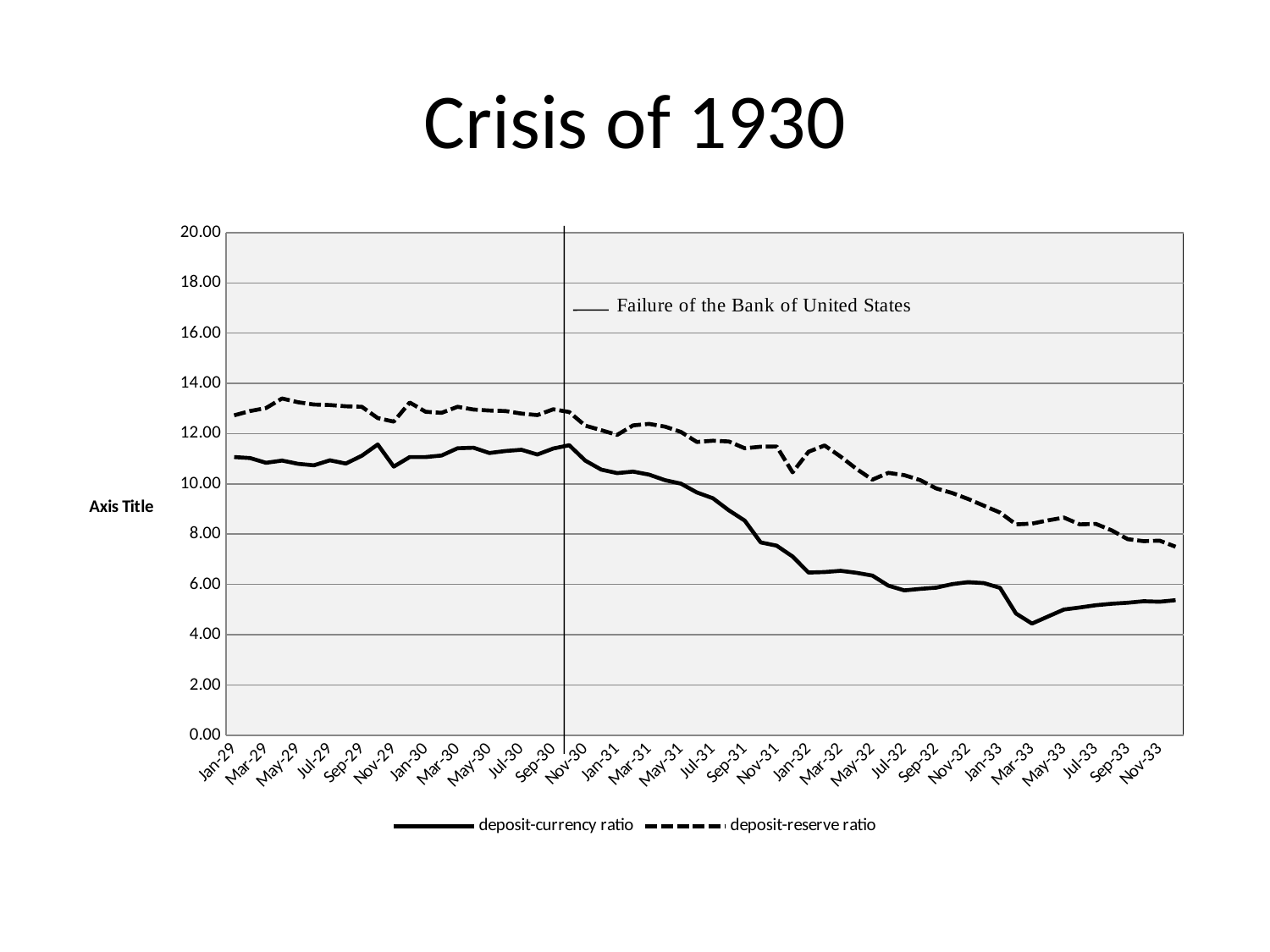
Is the deposit-reserve ratio at Nov-32 greater or less than 8.00? greater Is the deposit-reserve ratio at Nov-33 greater or less than 8.00? less What kind of chart is shown on the slide? line chart How many series does the legend list? 2 At Jan-32, which series has the higher value, deposit-currency ratio or deposit-reserve ratio? deposit-reserve ratio Is the deposit-reserve ratio at Jan-29 greater or less than 12.00? greater What is the title of the chart? Crisis of 1930 Does the deposit-currency ratio rise or fall from Jan-29 to Nov-33? fall What event does the vertical line on the chart mark? Failure of the Bank of United States Does the deposit-reserve ratio rise or fall from Jan-29 to Nov-33? fall